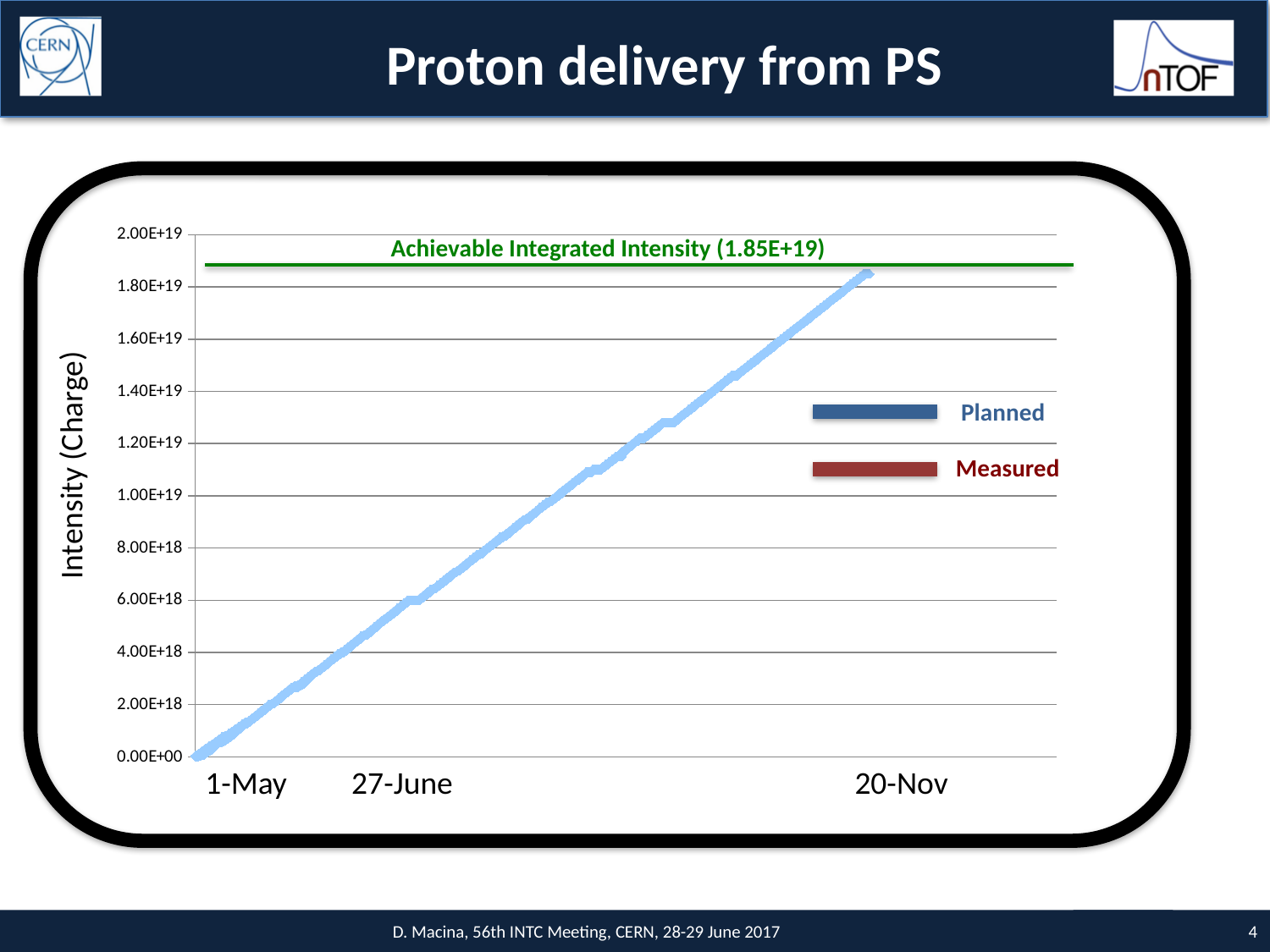
How many date labels are shown on the x axis? 3 How many series does the chart legend list? 2 Does the Planned intensity rise or fall from 1-May to 20-Nov? rise Which two series are listed in the chart legend? Planned and Measured What value is given for the Achievable Integrated Intensity line? 1.85E+19 At which date label is the Planned line at its lowest value? 1-May Is the Planned intensity at 20-Nov greater or less than 1.60E+19? greater What is the label of the y axis? Intensity (Charge) At which date label does the Planned line reach its highest value? 20-Nov What kind of chart is shown on the slide? line chart Is the Planned intensity at 27-June greater or less than 4.00E+18? greater